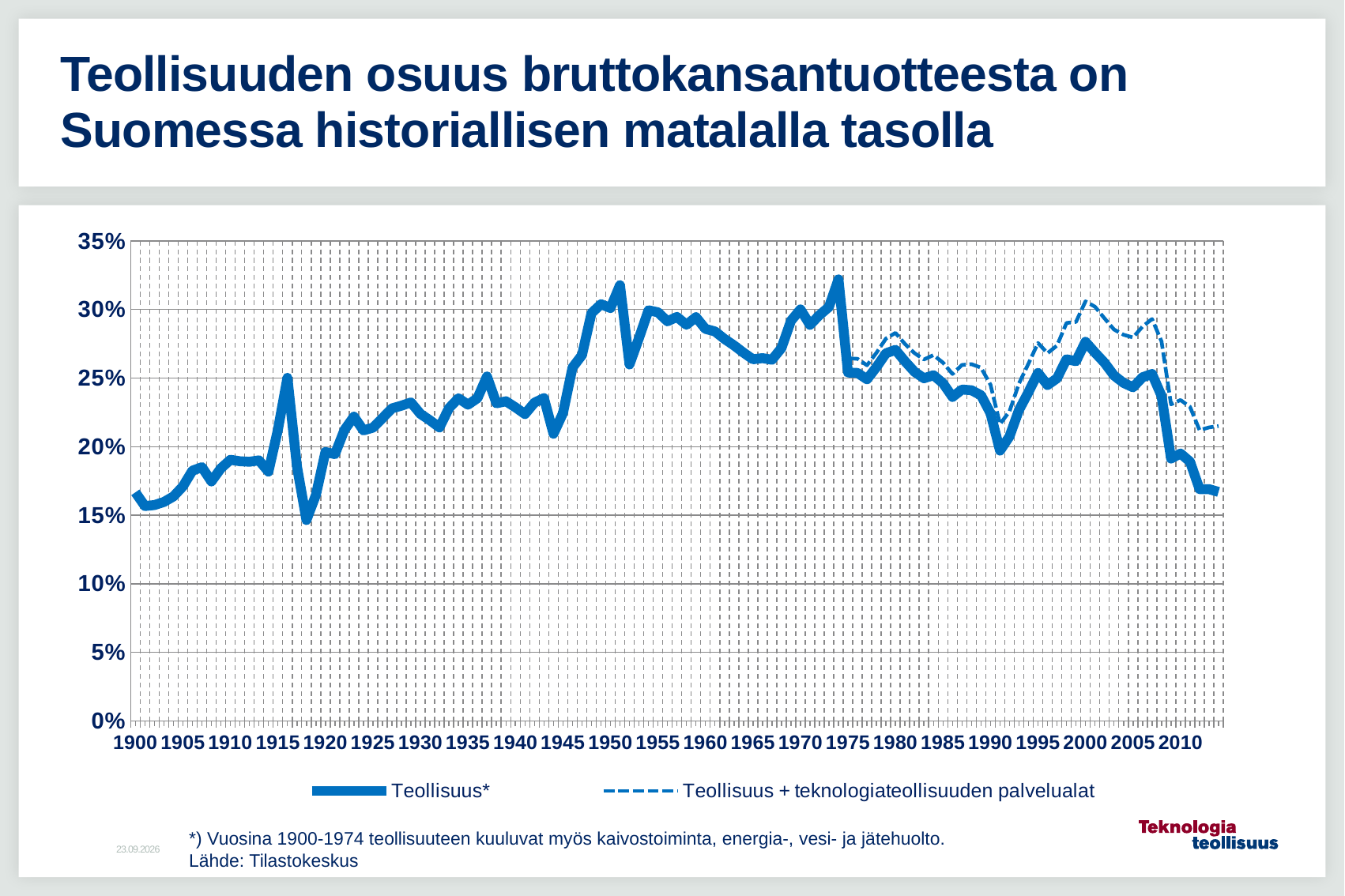
Is the value of Teollisuus* in 1900 greater or less than 20%? less What kind of chart is shown on the slide? Line chart Is the value of Teollisuus* in 1975 greater or less than 30%? less Is the last plotted value of Teollisuus* (around 2013) greater or less than 20%? less What source is cited below the chart? Tilastokeskus Does the Teollisuus* line rise or fall between 2000 and the end of the series? fall In 2000, which series has the higher value: Teollisuus* or Teollisuus + teknologiateollisuuden palvelualat? Teollisuus + teknologiateollisuuden palvelualat How many series does the legend list? 2 Which series is drawn with a dashed line? Teollisuus + teknologiateollisuuden palvelualat Which is larger for Teollisuus*: the value in 1900 or the value in 1950? 1950